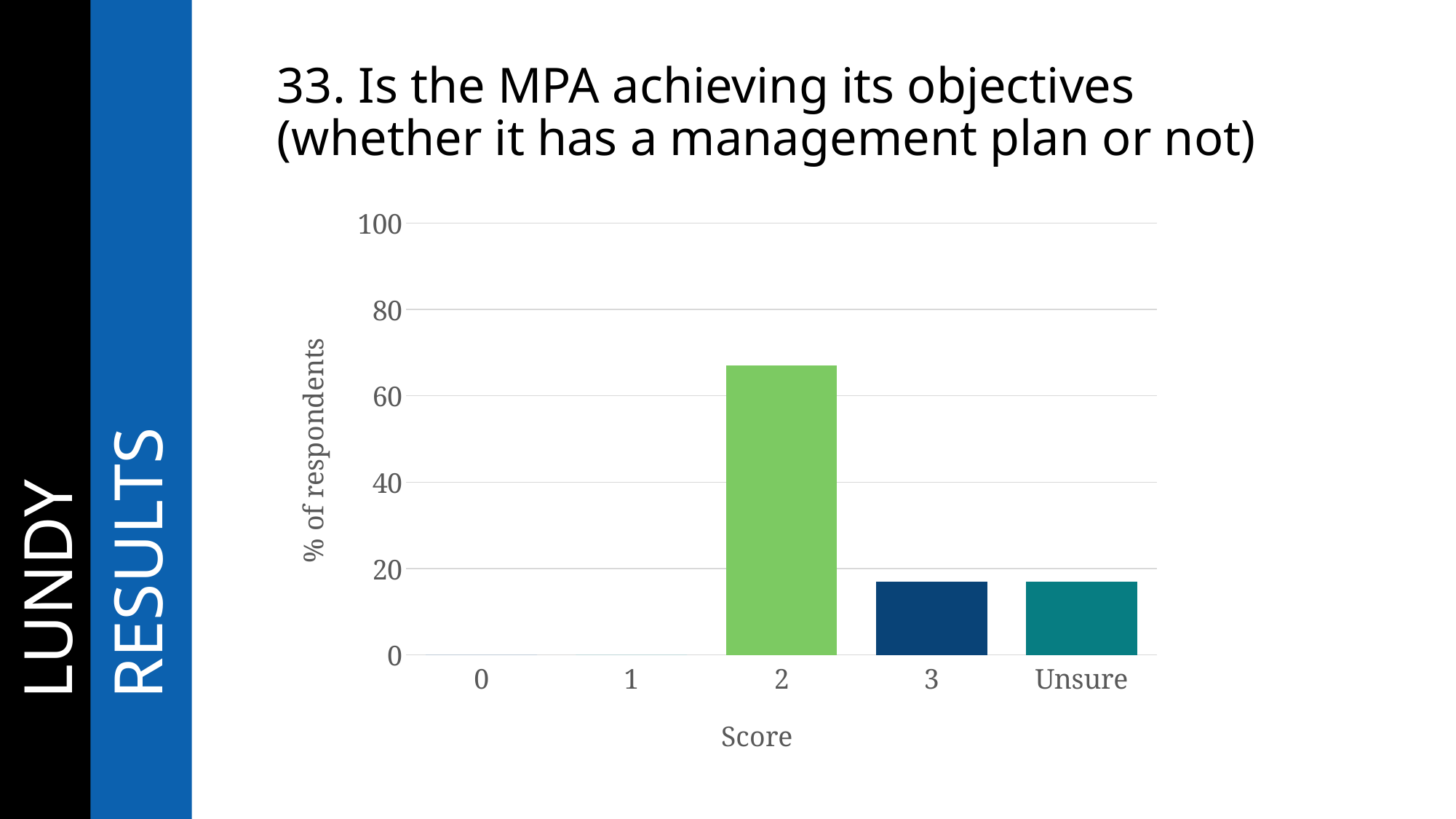
Is the value for score 3 greater or less than 20? less How many score categories are shown on the x axis? 5 Is the value for score 2 greater or less than 80? less Which score category has the highest percentage of respondents? 2 Is the value for Unsure greater or less than 20? less What is the label of the y axis? % of respondents What is the label of the x axis? Score What kind of chart is shown on the slide? bar chart What is the percentage of respondents for score 1? 0 What is the percentage of respondents for score 0? 0 Which has a higher percentage of respondents, score 2 or score 3? 2